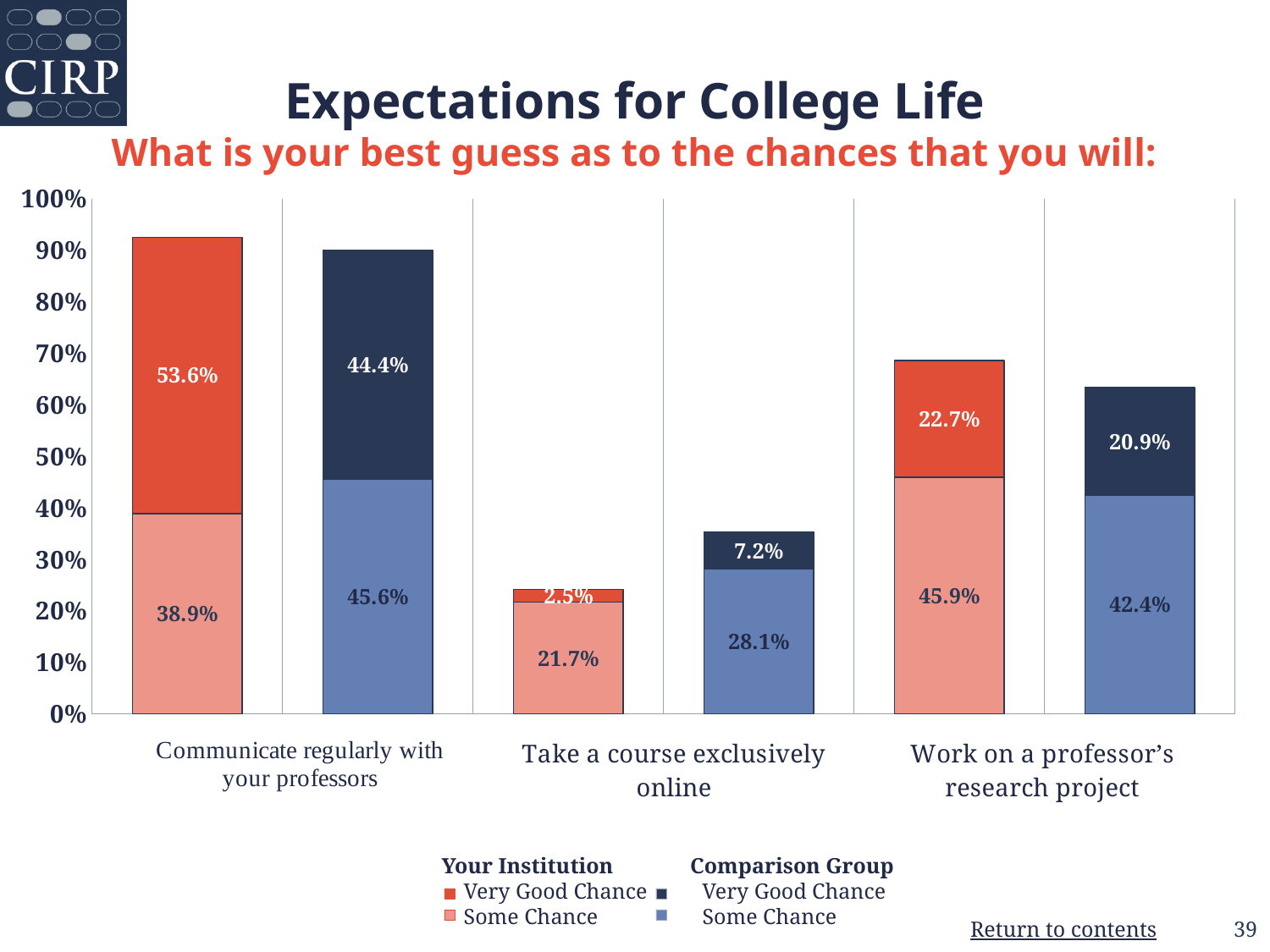
What is the 'Very Good Chance' value for the Comparison Group for 'Work on a professor's research project'? 20.9% Which category has the lowest 'Very Good Chance' value for Your Institution? Take a course exclusively online What is the total stacked value of the Your Institution bar for 'Communicate regularly with your professors'? 92.5% Which category has the highest 'Some Chance' value for the Comparison Group? Communicate regularly with your professors For 'Take a course exclusively online', is the 'Very Good Chance' value larger for Your Institution or the Comparison Group? Comparison Group What is the total stacked value of the Comparison Group bar for 'Take a course exclusively online'? 35.3% What is the 'Some Chance' value for the Comparison Group for 'Take a course exclusively online'? 28.1% How many series does the legend list? 4 How many categories are shown on the x axis? 3 What kind of chart is shown on the slide? Stacked bar chart What is the difference between the 'Some Chance' values for Your Institution and the Comparison Group for 'Work on a professor's research project'? 3.5% What is the 'Very Good Chance' value for Your Institution for 'Communicate regularly with your professors'? 53.6%